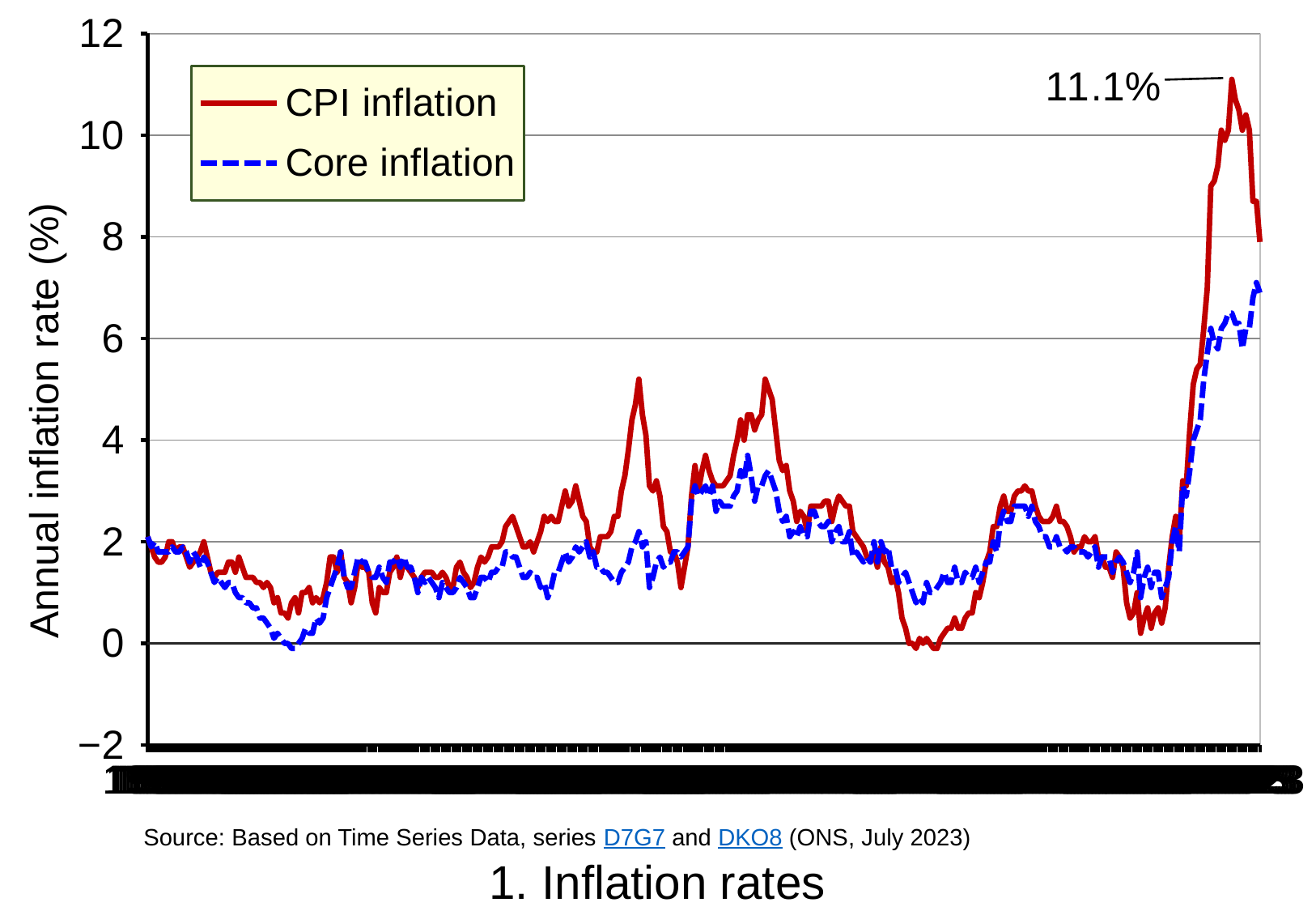
What is the label on the vertical axis? Annual inflation rate (%) At the point labelled 11.1%, which series is higher, CPI inflation or Core inflation? CPI inflation Is the peak value of the Core inflation line greater or less than 8? less How many series does the legend list? 2 What is the highest value labelled on the CPI inflation line? 11.1% Is the peak value of the Core inflation line greater or less than 6? greater Which series reaches the highest value on the chart? CPI inflation Is the lowest value of the CPI inflation line greater or less than 2? less What kind of chart is shown on the slide? line chart What is the title of the chart? 1. Inflation rates